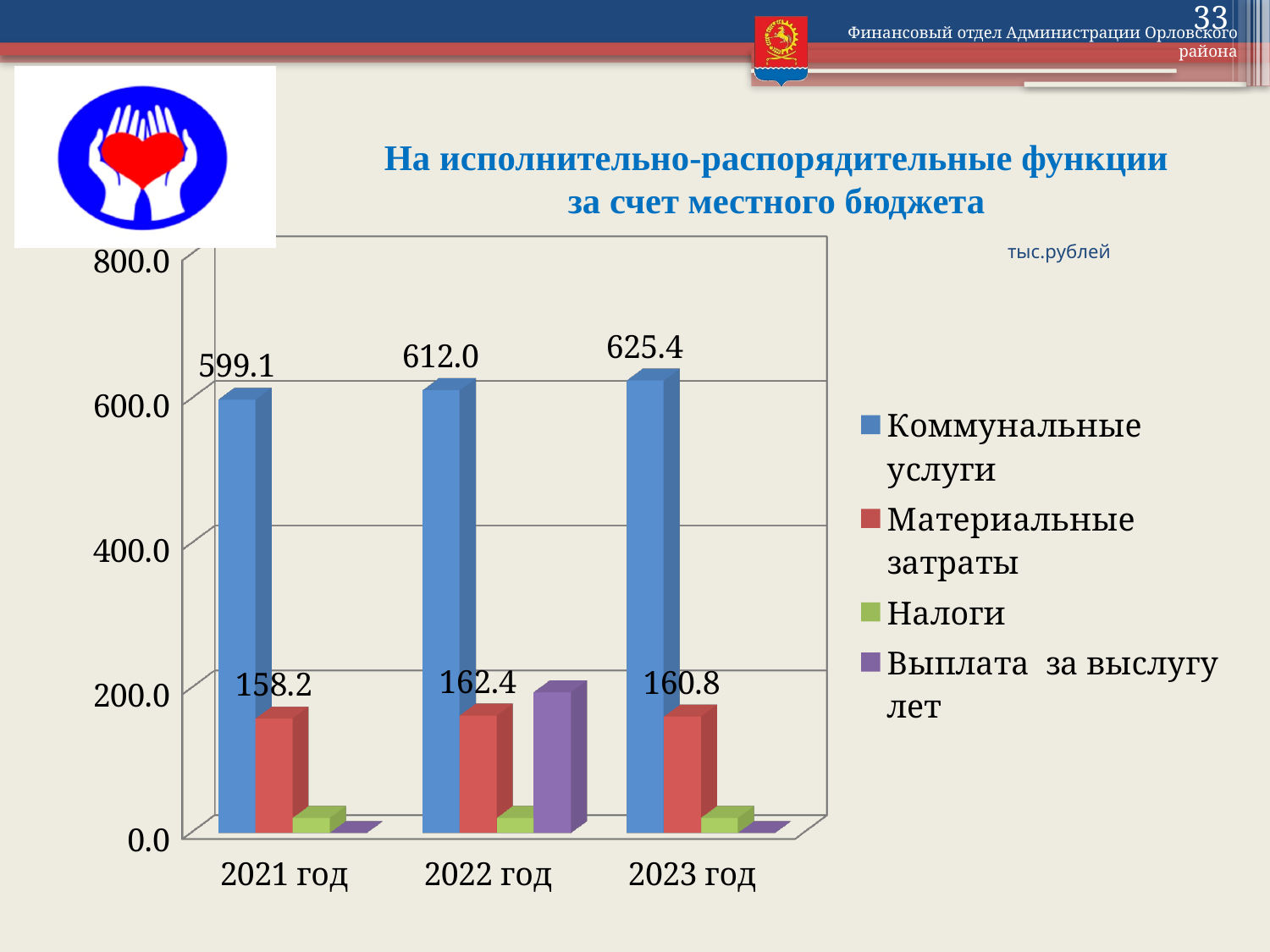
What kind of chart is shown on the slide? bar chart What is the value for Коммунальные услуги in 2021 год? 599.1 How many series does the legend list? 4 What is the value for Коммунальные услуги in 2023 год? 625.4 What is the value for Материальные затраты in 2022 год? 162.4 Do the values for Коммунальные услуги rise or fall from 2021 год to 2023 год? rise In which year is the value for Материальные затраты the lowest? 2021 год What is the difference between the Коммунальные услуги values for 2023 год and 2021 год? 26.3 How many years are shown on the x axis? 3 In which year is the value for Коммунальные услуги the highest? 2023 год Which is larger: Материальные затраты in 2022 год or in 2023 год? 2022 год